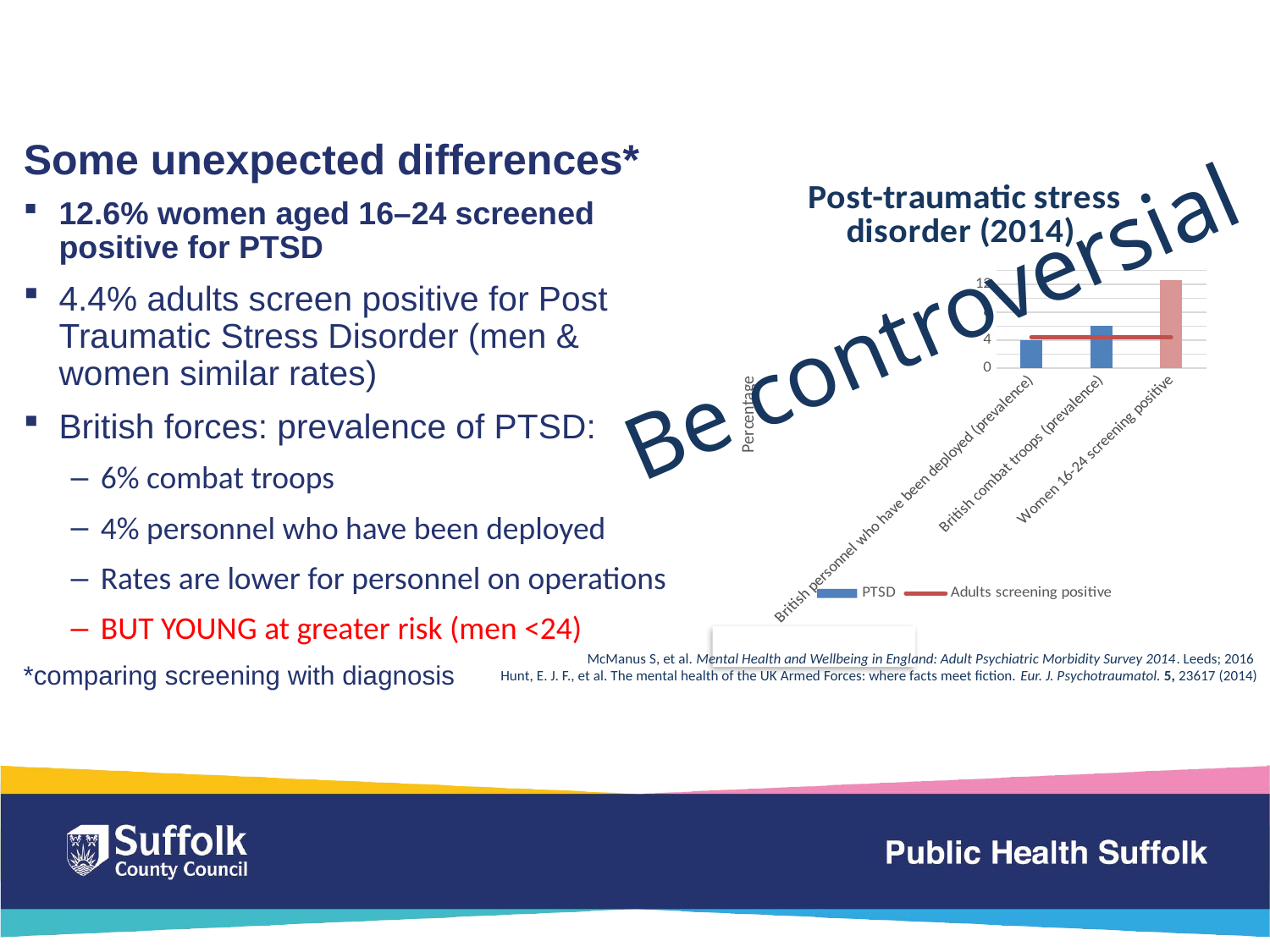
Is the PTSD value for Women 16-24 screening positive greater or less than 4? greater How many categories are shown on the x axis of the chart? 3 What kind of chart is shown on the slide? combination bar and line chart Is the PTSD value for British combat troops (prevalence) greater or less than 12? less Which category has the highest PTSD bar in the chart? Women 16-24 screening positive What is the label on the vertical axis of the chart? Percentage How many series does the chart's legend list? 2 Which category has the lowest PTSD bar in the chart? British personnel who have been deployed (prevalence) Which has a larger PTSD bar: British combat troops (prevalence) or British personnel who have been deployed (prevalence)? British combat troops (prevalence) Is the PTSD value for British combat troops (prevalence) greater or less than 4? greater What is the title of the chart on the slide? Post-traumatic stress disorder (2014)